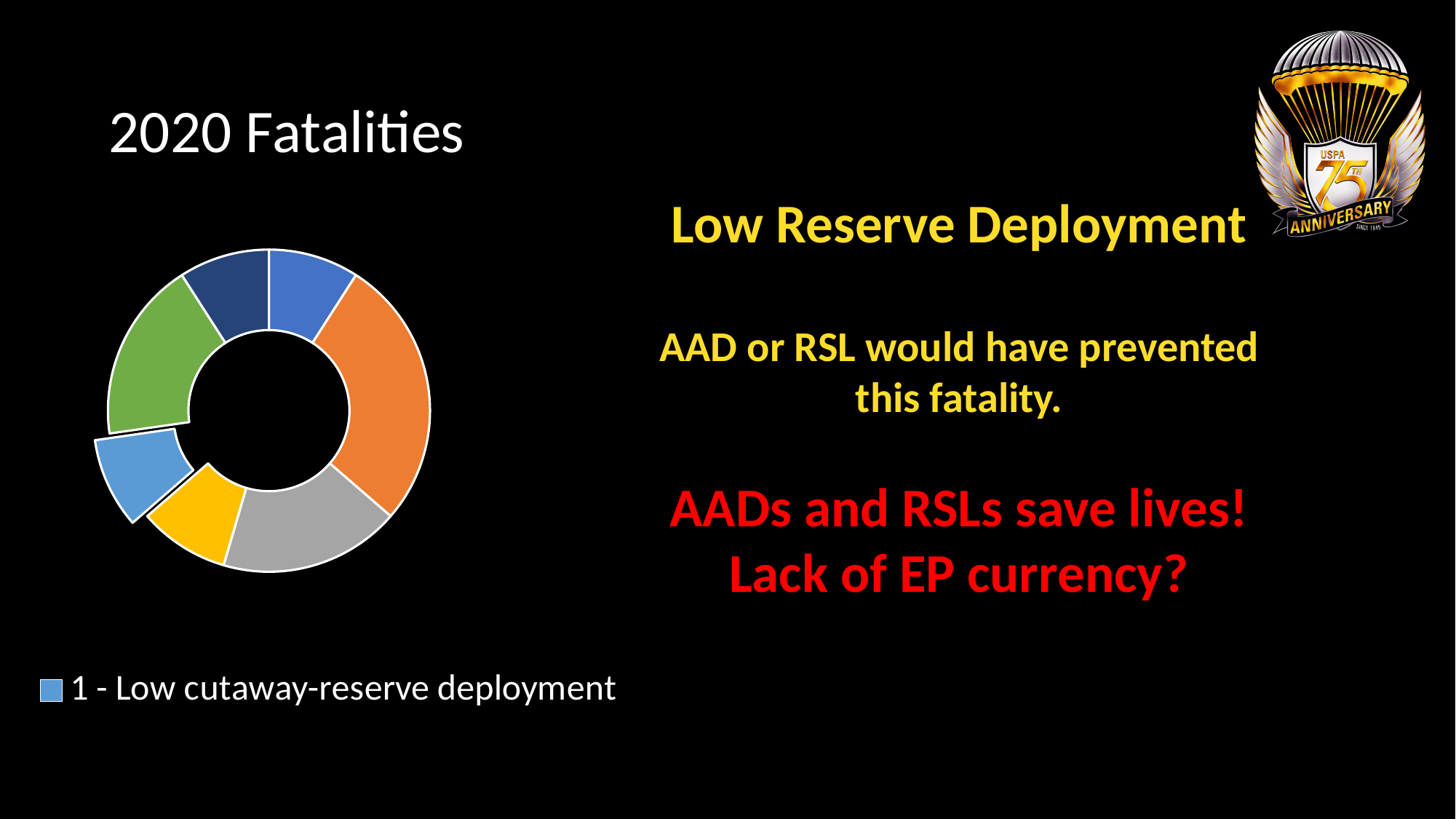
What kind of chart is shown on the slide? Doughnut (pie) chart How many fatalities does the legend attribute to low cutaway-reserve deployment? 1 How many entries does the chart legend list? 1 What is the legend entry shown below the chart? 1 - Low cutaway-reserve deployment Which is larger, the green slice or the light blue (exploded) slice? Green What is the title of the chart on the slide? 2020 Fatalities Which colour slice is the largest in the doughnut chart? Orange Which is larger, the orange slice or the gray slice? Orange How many slices does the doughnut chart contain? 7 Which is larger, the orange slice or the green slice? Orange